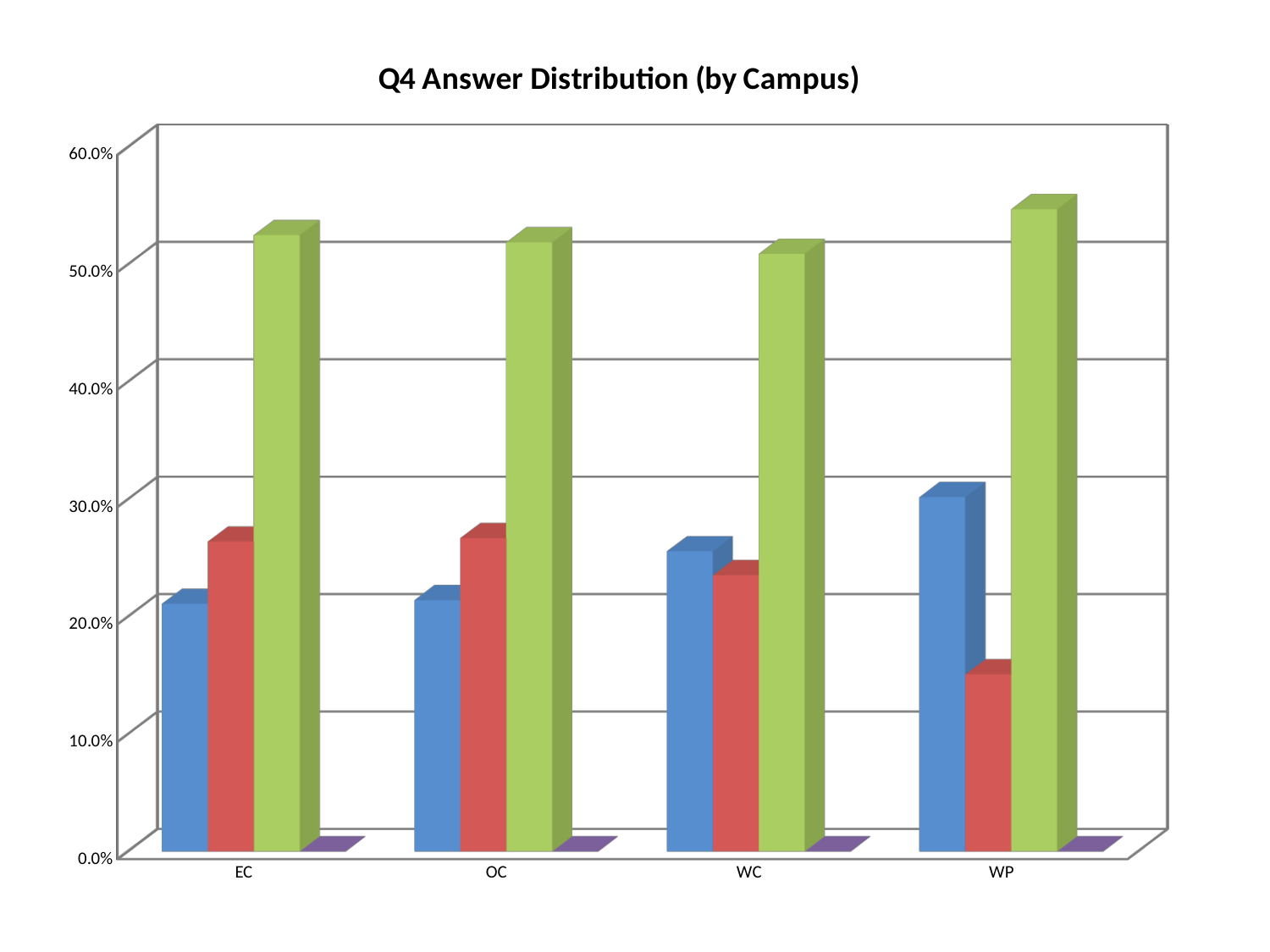
Which campus has the shortest red bar? WP What kind of chart is shown on the slide? bar chart Is the green bar for WP greater or less than 50.0%? greater Is the red bar for WP greater or less than 20.0%? less How many campuses are shown on the x axis? 4 Which campus has the tallest green bar? WP What is the title of the chart? Q4 Answer Distribution (by Campus) Which campus has the tallest blue bar? WP Is the blue bar for EC greater or less than 30.0%? less For WP, which is larger, the blue bar or the red bar? the blue bar Do the blue bars rise or fall moving from EC to WP along the x axis? rise